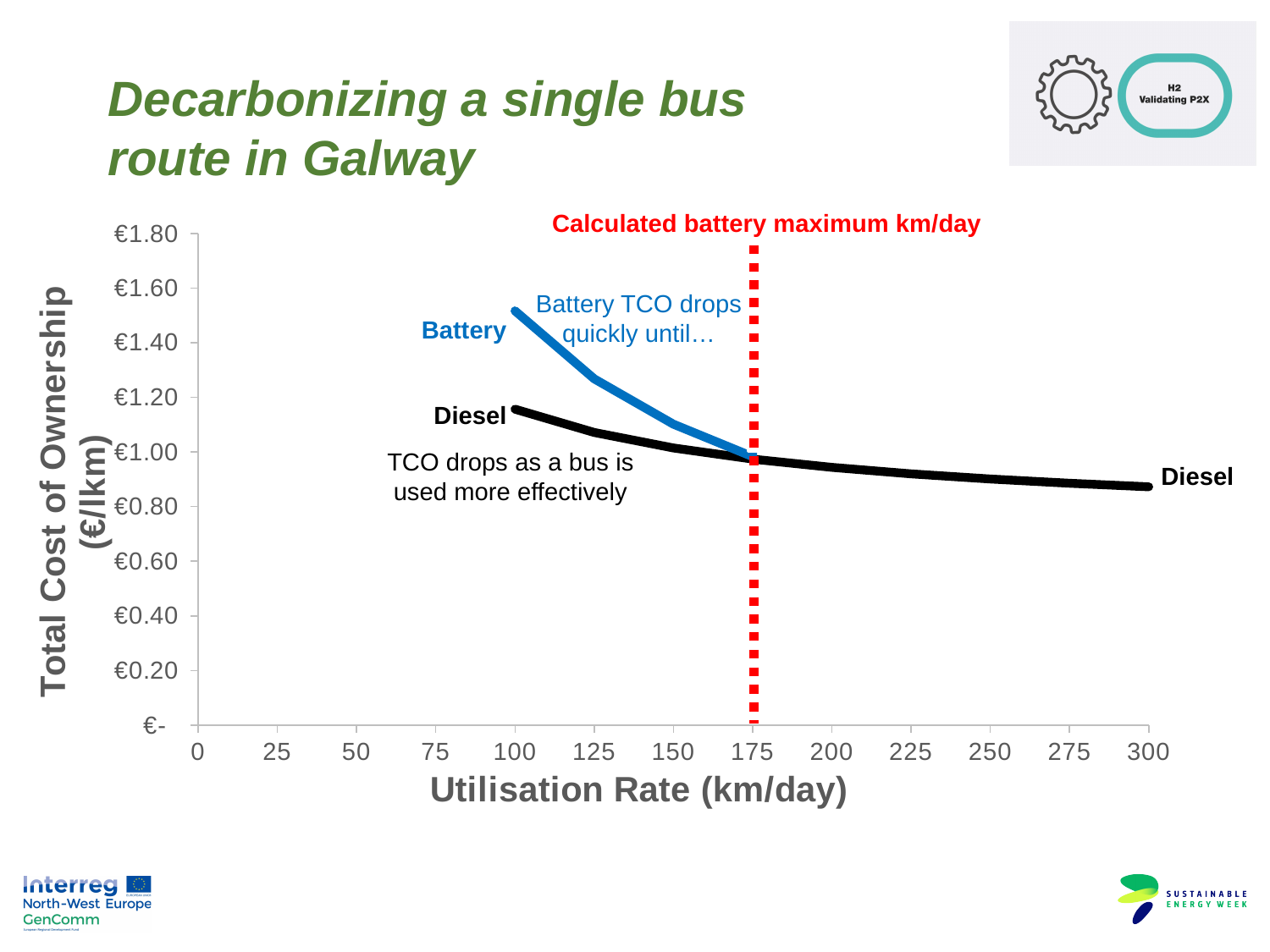
Does the Battery TCO rise or fall as the utilisation rate increases? fall Does the Diesel TCO rise or fall as the utilisation rate increases? fall Is the Diesel value at 300 km/day greater or less than €1.00? less At 100 km/day, which series has the higher total cost of ownership, Battery or Diesel? Battery Is the Battery value at 100 km/day greater or less than €1.40? greater Is the Battery value at 150 km/day greater or less than €1.00? greater What kind of chart is shown on the slide? line chart How many series are plotted on the chart? 2 Which series extends all the way to 300 km/day on the x axis? Diesel At what utilisation rate is the red dashed line labelled 'Calculated battery maximum km/day' drawn? 175